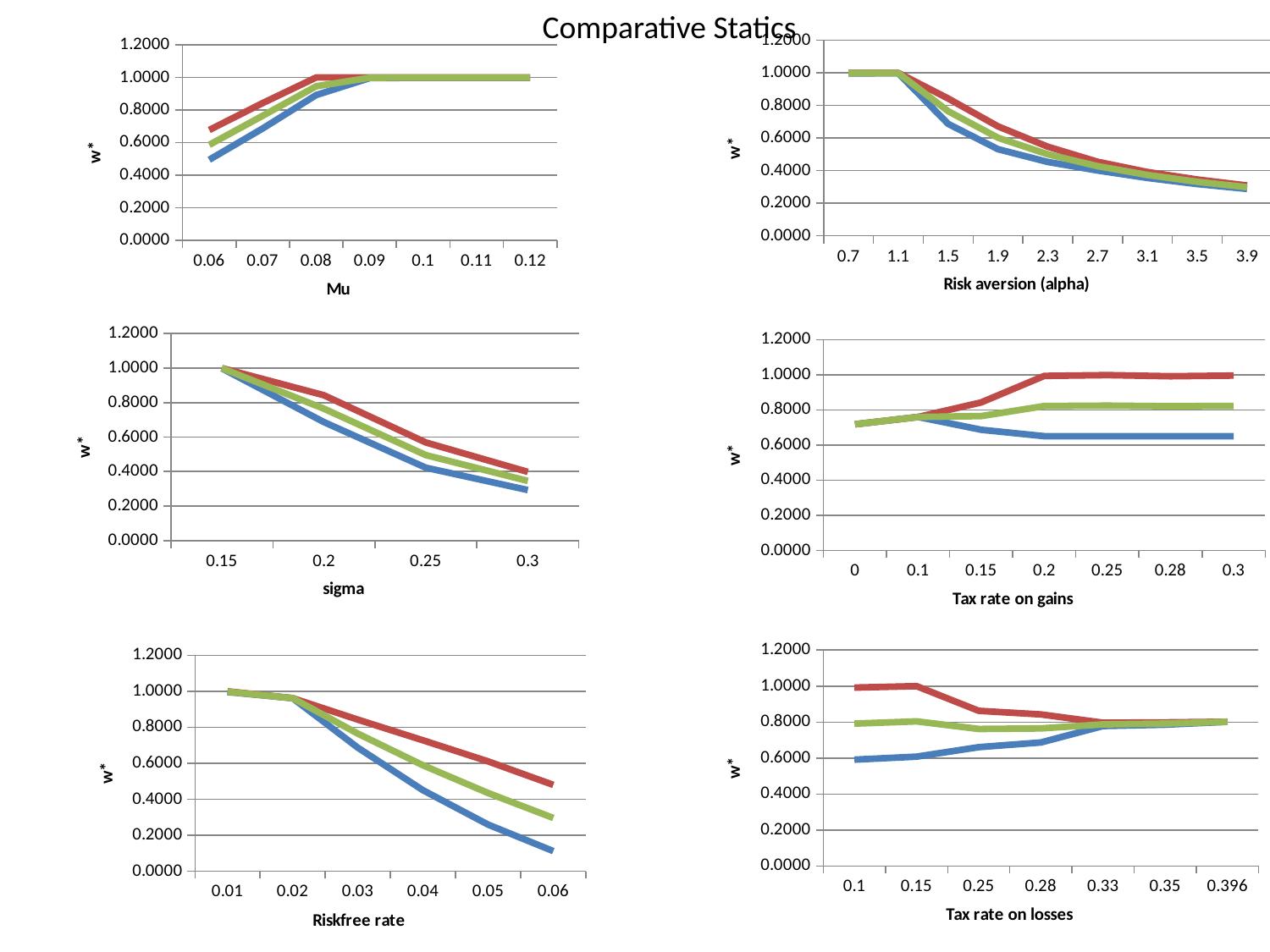
In the chart with the x-axis labelled 'sigma', how many x-axis points are there? 4 In the chart with the x-axis labelled 'Riskfree rate', do the lines rise or fall as the riskfree rate increases? fall In the chart with the x-axis labelled 'sigma', do the lines rise or fall as sigma increases? fall How many charts are shown on the slide? 6 In the chart with the x-axis labelled 'Mu', how many x-axis points are there? 7 In the chart with the x-axis labelled 'Riskfree rate', how many x-axis points are there? 6 What kind of chart is the chart with the x-axis labelled 'Mu'? line chart In the chart with the x-axis labelled 'Riskfree rate', is the value of the blue line at 0.06 greater or less than 0.2000? less What is the title of the slide? Comparative Statics In the chart with the x-axis labelled 'Tax rate on gains', is the value of the red line at 0.3 greater or less than 0.8000? greater